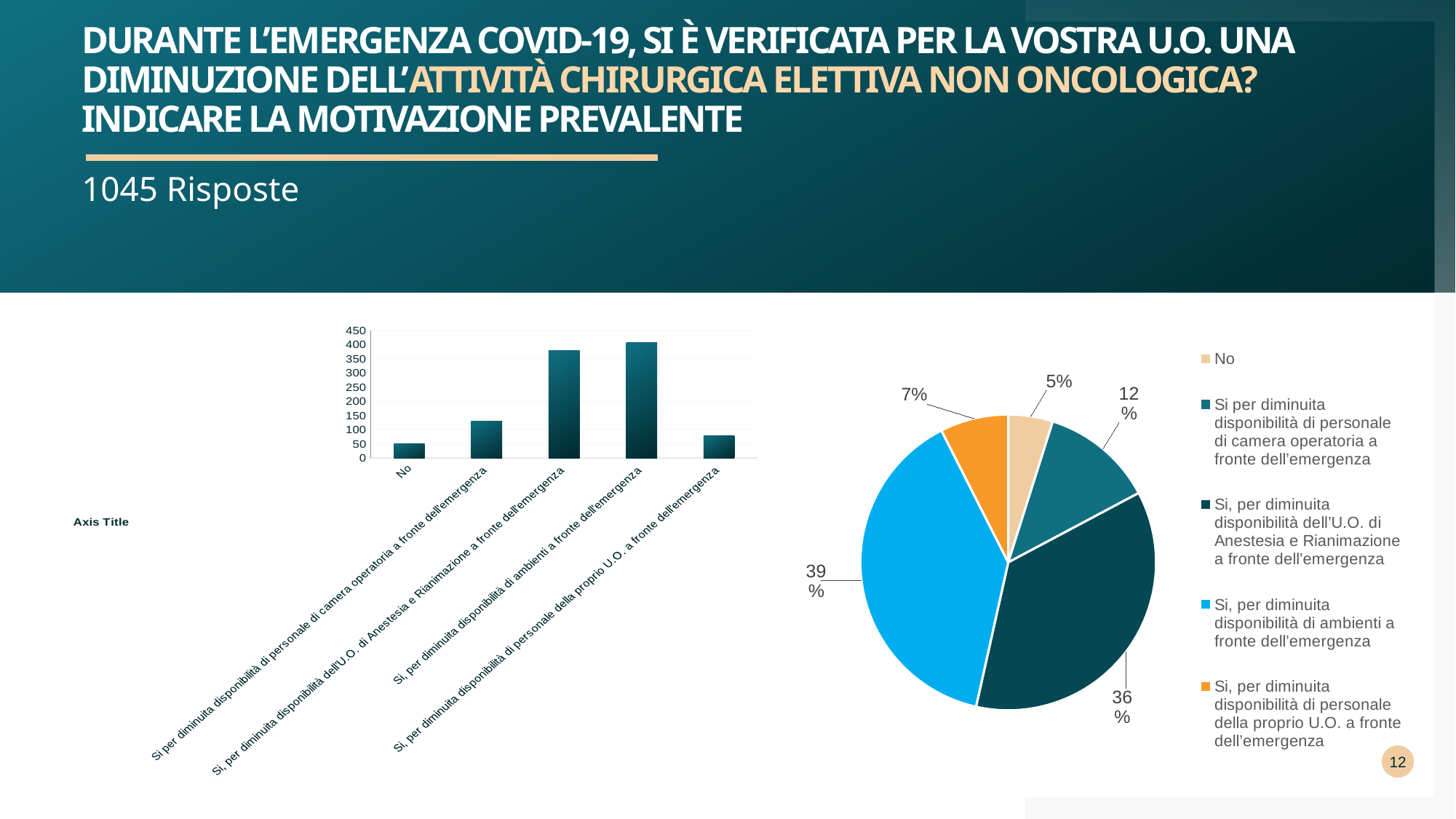
In the pie chart on the right, what is the difference in percentage points between the 'ambienti' slice (39%) and the 'U.O. di Anestesia e Rianimazione' slice (36%)? 3 percentage points How many entries does the legend of the pie chart on the right list? 5 In the bar chart on the left, which category has the highest bar? Si, per diminuita disponibilità di ambienti a fronte dell'emergenza In the bar chart on the left, is the value for 'Si, per diminuita disponibilità dell'U.O. di Anestesia e Rianimazione a fronte dell'emergenza' greater or less than 350? greater What kind of chart is the chart on the left of the slide? bar chart In the pie chart on the right, what share is labelled for 'Si, per diminuita disponibilità di ambienti a fronte dell'emergenza'? 39% In the pie chart on the right, what share is labelled for 'No'? 5% In the bar chart on the left, how many categories are shown on the x axis? 5 In the bar chart on the left, is the value for 'No' greater or less than 100? less What kind of chart is the chart on the right of the slide? pie chart In the bar chart on the left, which category has the lowest bar? No